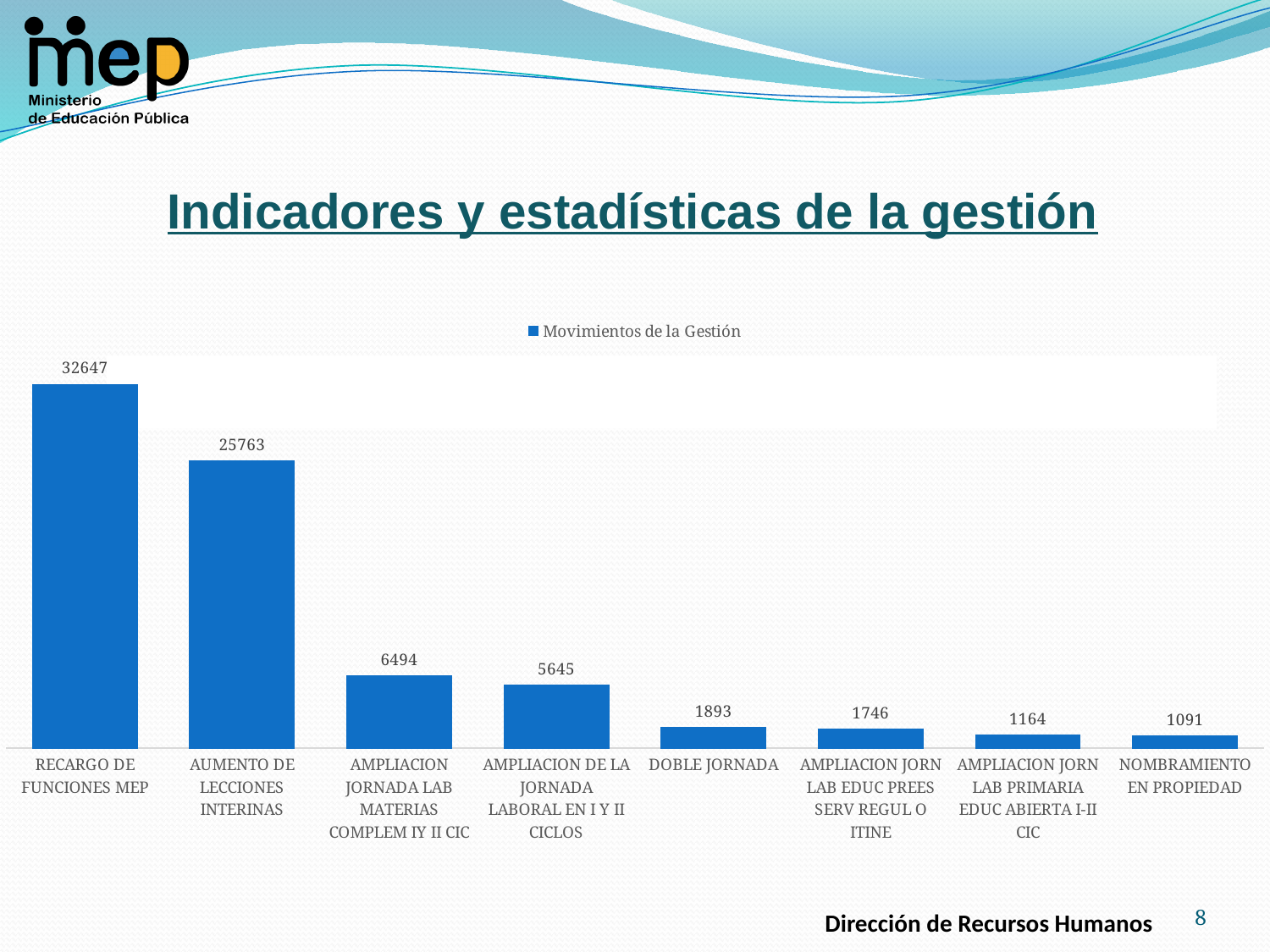
Which category has the lowest value? NOMBRAMIENTO EN PROPIEDAD What is the difference between AMPLIACION JORNADA LAB MATERIAS COMPLEM IY II CIC and AMPLIACION DE LA JORNADA LABORAL EN I Y II CICLOS? 849 What is the difference between RECARGO DE FUNCIONES MEP and AUMENTO DE LECCIONES INTERINAS? 6884 Which category has the highest value? RECARGO DE FUNCIONES MEP How many series does the legend list? 1 What is the value for NOMBRAMIENTO EN PROPIEDAD? 1091 What is the value for RECARGO DE FUNCIONES MEP? 32647 How many categories are shown in the chart? 8 What is the value for DOBLE JORNADA? 1893 What is the name of the series shown in the legend? Movimientos de la Gestión What kind of chart is shown? bar chart Which is larger, DOBLE JORNADA or AMPLIACION JORN LAB EDUC PREES SERV REGUL O ITINE? DOBLE JORNADA